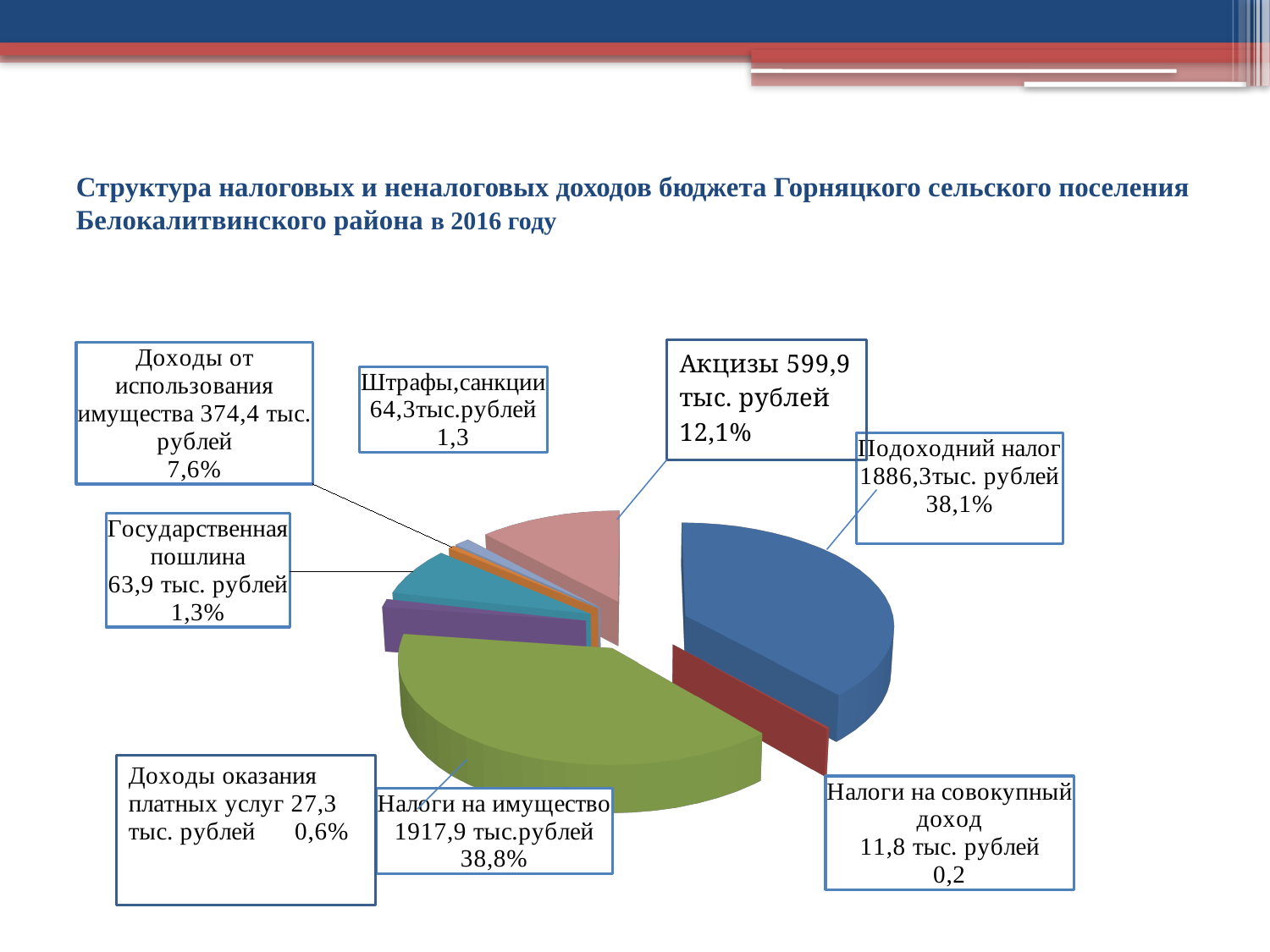
Which category has the smallest value? Налоги на совокупный доход Which category has the largest value? Налоги на имущество What share of the pie does Налоги на имущество represent? 38,8% What is the difference between the values for Налоги на имущество and Подоходний налог? 31,6 тыс. рублей What share of the pie does Акцизы represent? 12,1% What is the value for Акцизы? 599,9 тыс. рублей Which is larger, the value for Штрафы,санкции or the value for Государственная пошлина? Штрафы,санкции What is the value for Доходы от использования имущества? 374,4 тыс. рублей Which year does the chart title refer to? 2016 What kind of chart is shown on the slide? pie chart How many categories (slices) does the pie chart have? 8 What is the value for Подоходний налог? 1886,3 тыс. рублей